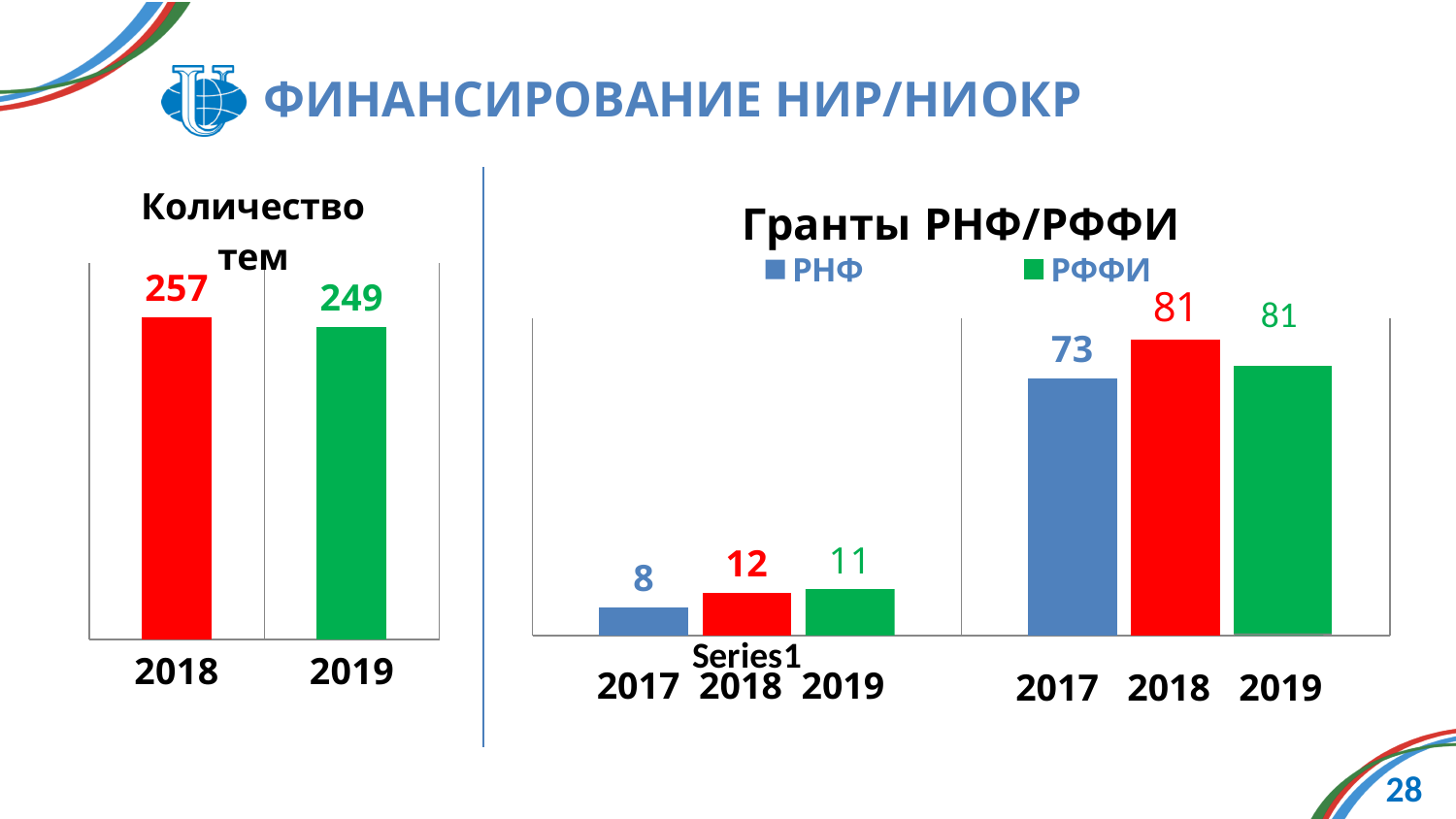
In the 'Гранты РНФ/РФФИ' chart, what is the РНФ value for 2018? 12 What type of chart is the 'Гранты РНФ/РФФИ' chart? Bar chart In the 'Количество тем' chart, what is the difference between the 2018 and 2019 values? 8 In the 'Гранты РНФ/РФФИ' chart, which year has the lowest РНФ value? 2017 In the 'Количество тем' chart, what is the value for 2019? 249 In the 'Гранты РНФ/РФФИ' chart, what is the РНФ value for 2017? 8 In the 'Гранты РНФ/РФФИ' chart, what is the РФФИ value for 2019? 81 In the 'Количество тем' chart, what is the value for 2018? 257 In the 'Количество тем' chart, which year has the higher value? 2018 In the 'Гранты РНФ/РФФИ' chart, what is the РФФИ value for 2017? 73 How many series does the legend of the 'Гранты РНФ/РФФИ' chart list? 2 In the 'Гранты РНФ/РФФИ' chart, what is the difference between the РФФИ value for 2018 and the РНФ value for 2018? 69